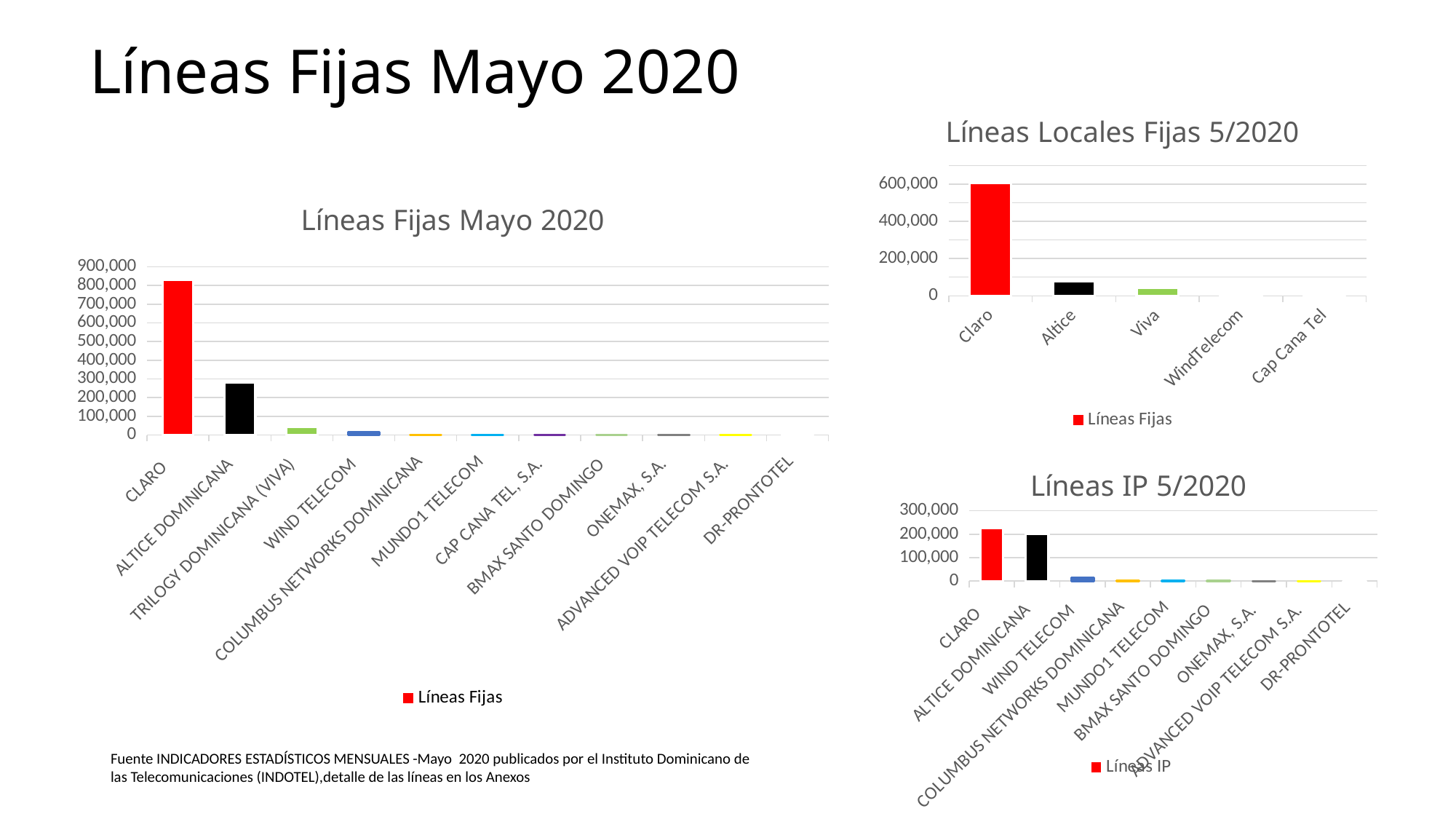
In the chart titled 'Líneas IP 5/2020', is the value for CLARO greater or less than 200,000? greater In the chart titled 'Líneas Fijas Mayo 2020', which category has the highest value? CLARO In the chart titled 'Líneas Fijas Mayo 2020', is the value for ALTICE DOMINICANA greater or less than 300,000? less In the chart titled 'Líneas Fijas Mayo 2020', which is larger, the value for ALTICE DOMINICANA or the value for TRILOGY DOMINICANA (VIVA)? ALTICE DOMINICANA What is the legend entry shown for the chart titled 'Líneas IP 5/2020'? Líneas IP In the chart titled 'Líneas Fijas Mayo 2020', how many categories are shown on the x axis? 11 What kind of chart is 'Líneas Locales Fijas 5/2020'? bar chart In the chart titled 'Líneas Fijas Mayo 2020', is the value for CLARO greater or less than 800,000? greater In the chart titled 'Líneas Locales Fijas 5/2020', which category has the highest value? Claro In the chart titled 'Líneas Locales Fijas 5/2020', how many categories are shown on the x axis? 5 In the chart titled 'Líneas IP 5/2020', how many categories are shown on the x axis? 9